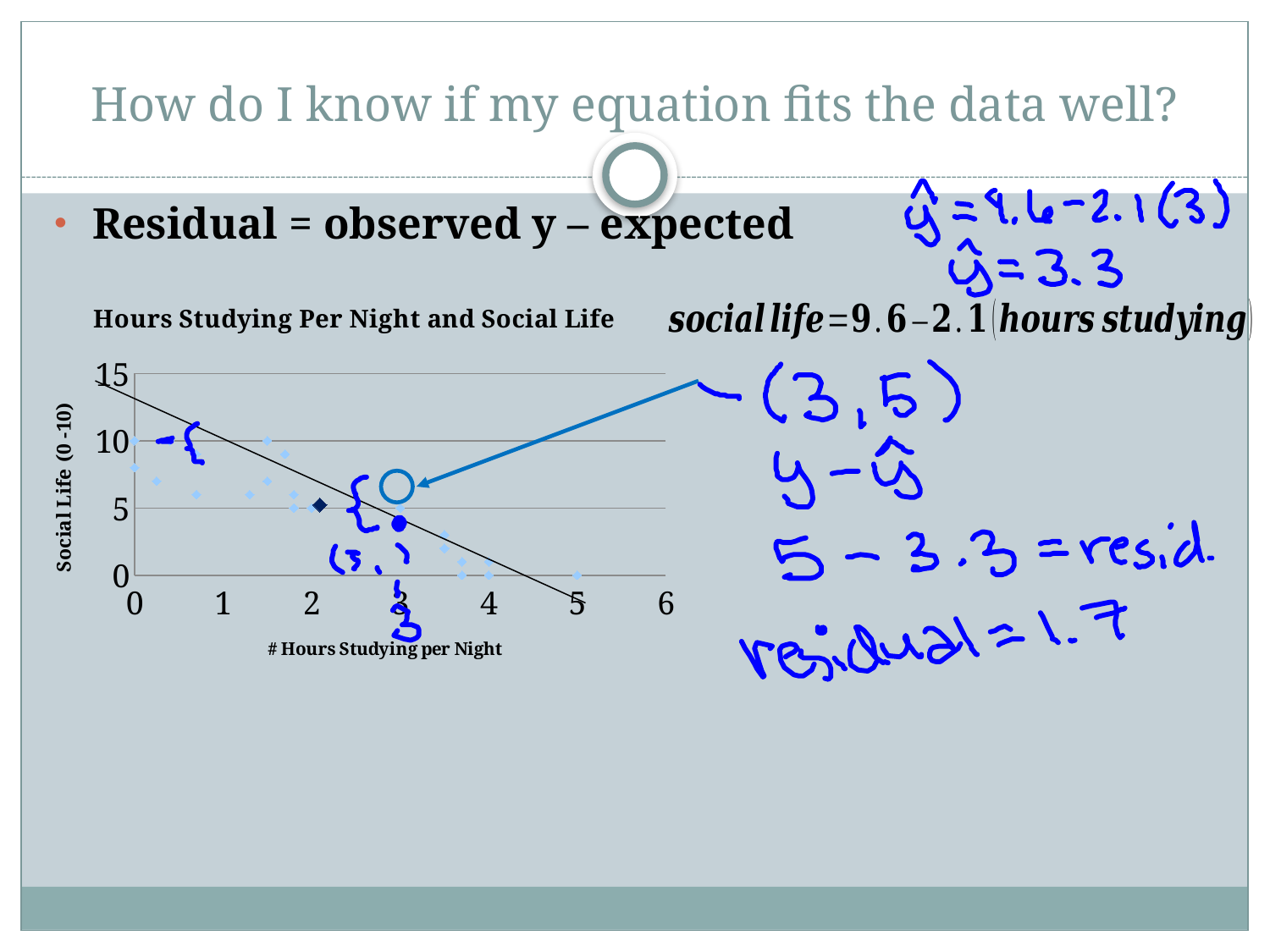
What coordinates are handwritten next to the circled point on the chart? (3,5) What is the highest value shown on the x axis of the chart? 6 What is the label on the x axis of the chart? # Hours Studying per Night Do the social life values generally rise or fall as hours studying per night increases? fall What is the highest value shown on the y axis of the chart? 15 What residual value is handwritten on the slide for the point (3,5)? 1.7 What is the title of the chart? Hours Studying Per Night and Social Life Is the social life value for the point at 0 hours studying greater or less than 5? greater Is the social life value for the point at 5 hours studying greater or less than 5? less What kind of chart is shown on the slide? scatter plot